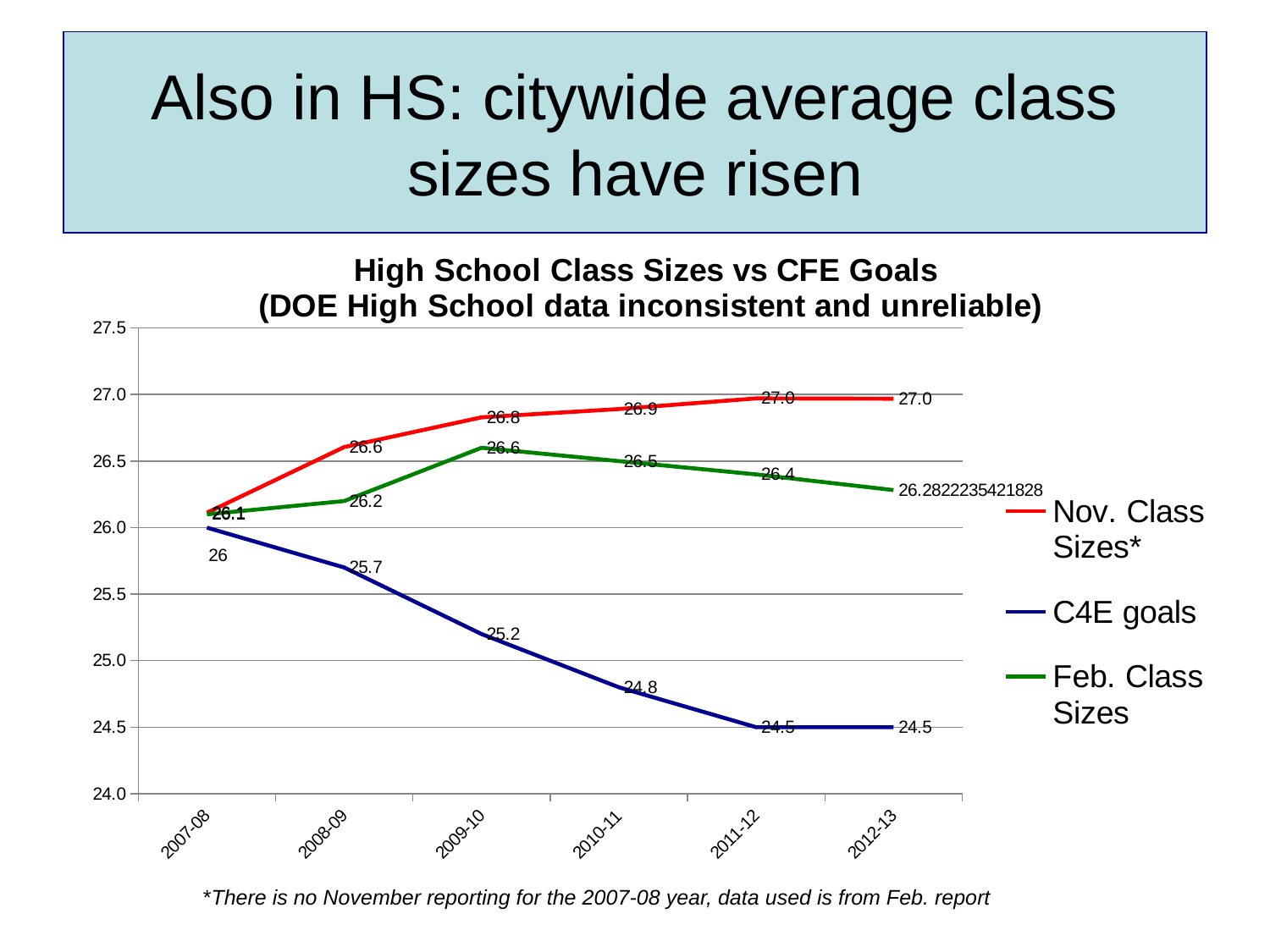
In 2010-11, which is larger: Nov. Class Sizes or Feb. Class Sizes? Nov. Class Sizes What kind of chart is shown on the slide? line chart What is the difference between the Nov. Class Sizes value and the C4E goals value in 2008-09? 0.9 What is the Nov. Class Sizes value for 2011-12? 27.0 In which school year is the C4E goals value highest? 2007-08 What is the Feb. Class Sizes value for 2009-10? 26.6 Is the C4E goals value for 2009-10 greater or less than 25.0? greater What is the difference between the Nov. Class Sizes value and the C4E goals value in 2012-13? 2.5 In which school year is the Feb. Class Sizes value lowest? 2007-08 What is the C4E goals value for 2010-11? 24.8 How many school years are shown on the x axis? 6 How many series does the legend list? 3